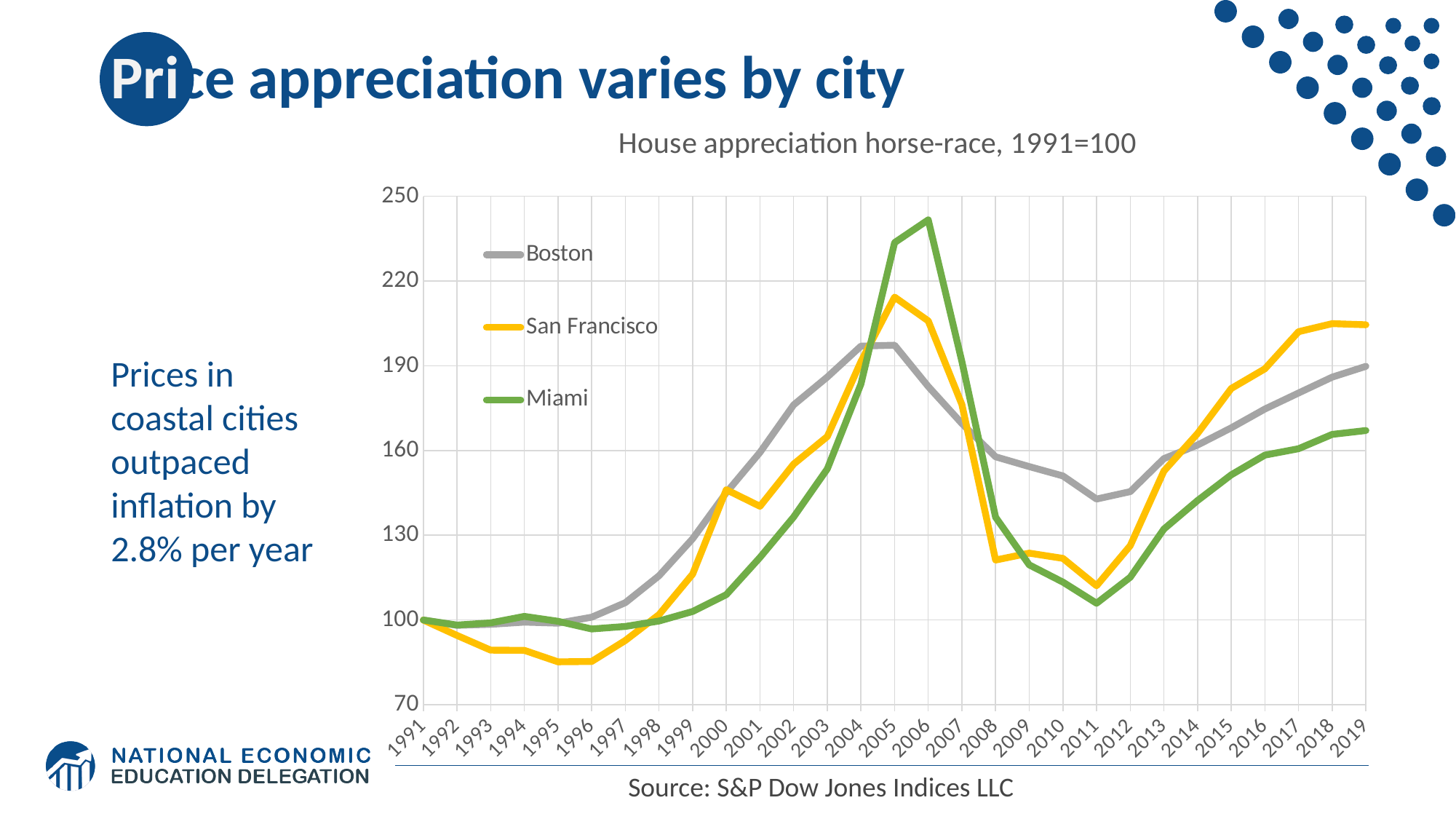
Is the value for San Francisco in 1995 greater or less than 100? less Which city has the highest index value in 2006? Miami How many series does the legend list? 3 Does the Miami line rise or fall from 2011 to 2019? rise What is the index value for Boston in 1991? 100 In 2008, which is higher: Boston or San Francisco? Boston What is the title of the chart? House appreciation horse-race, 1991=100 How many years are plotted along the x axis? 29 What kind of chart is shown on the slide? line chart Which city has the lowest index value in 2019? Miami Is the value for Miami in 2006 greater or less than 220? greater Is the value for Boston in 2011 greater or less than 160? less